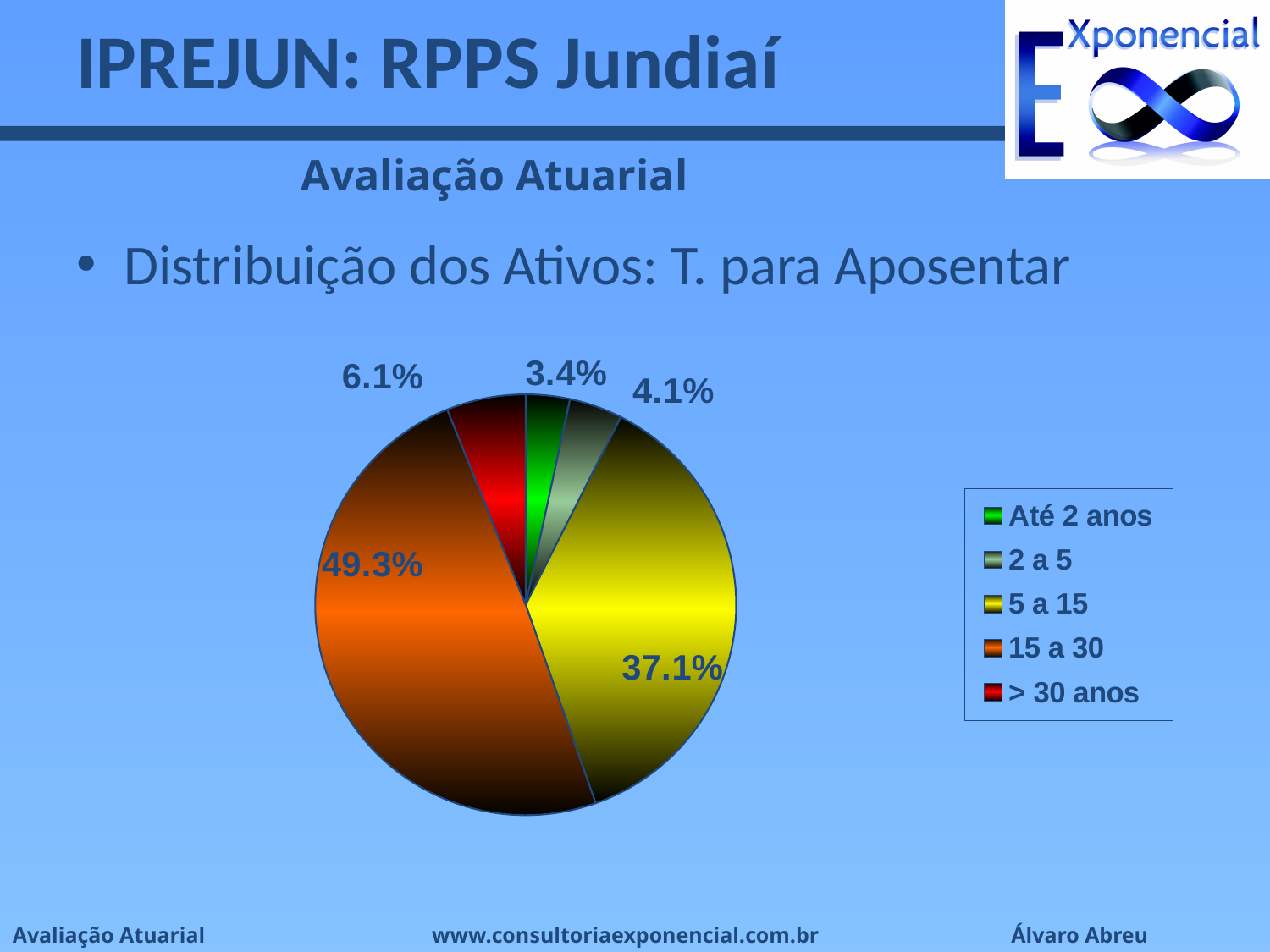
What is the value shown for 'Até 2 anos'? 3.4% What share of the pie does the '5 a 15' slice represent? 37.1% What is the difference between the '15 a 30' and '5 a 15' slices? 12.2% What is the value shown for '> 30 anos'? 6.1% What colour is the '5 a 15' slice? yellow What is the value shown for '2 a 5'? 4.1% How many categories does the legend list? 5 Which category has the smallest slice of the pie? Até 2 anos Which category has the largest slice of the pie? 15 a 30 What share of the pie does the '15 a 30' slice represent? 49.3% Which is larger, the '> 30 anos' slice or the '2 a 5' slice? > 30 anos What type of chart is shown on the slide? pie chart